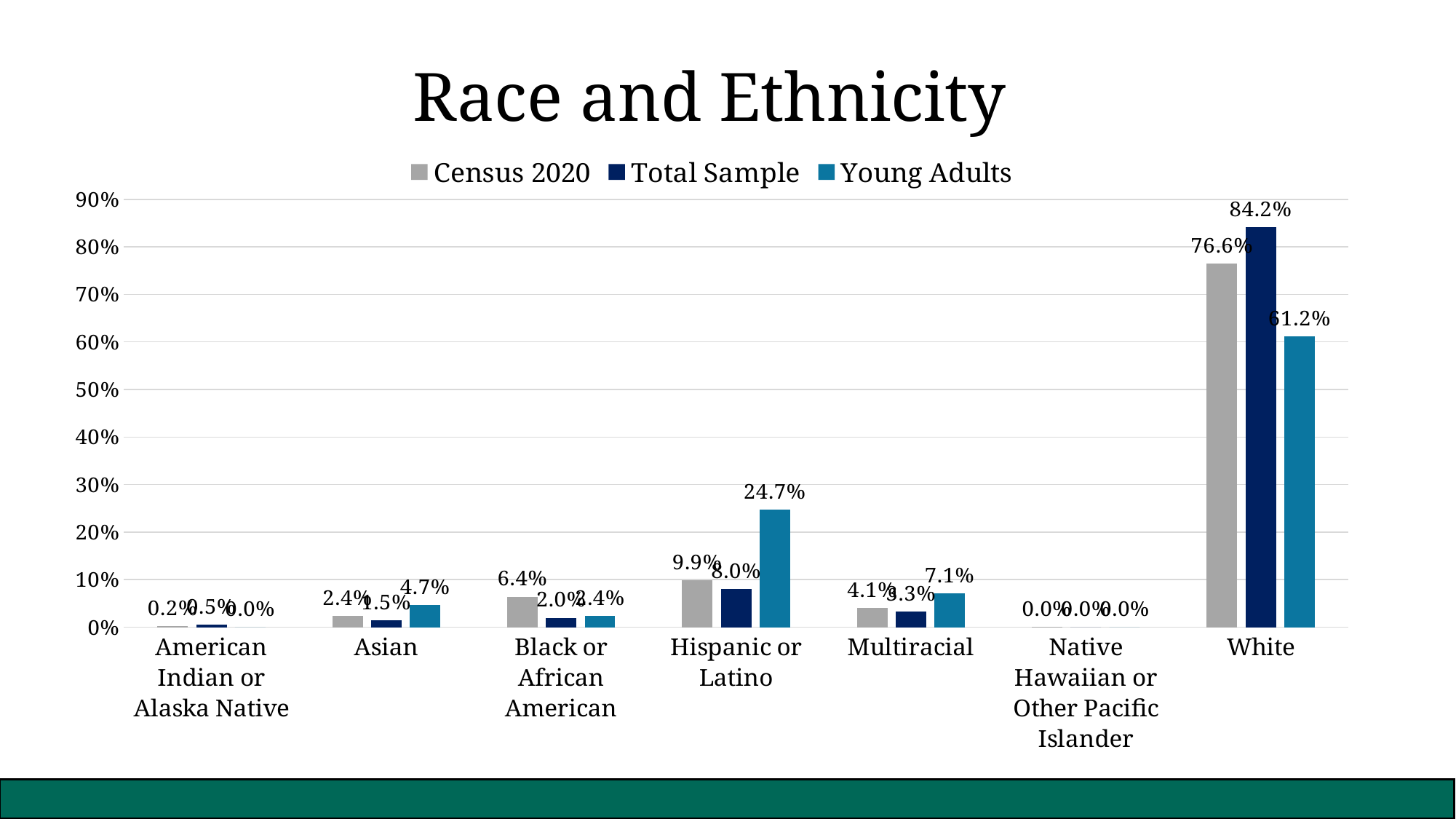
Is the Young Adults value for White greater or less than 70%? less What is the Total Sample value for White? 84.2% What is the Census 2020 value for Black or African American? 6.4% What is the Census 2020 value for White? 76.6% What is the Young Adults value for Hispanic or Latino? 24.7% How many series does the legend list? 3 What is the Young Adults value for Multiracial? 7.1% What kind of chart is shown on the slide? bar chart What is the difference between the Total Sample and Young Adults values for White? 23.0% How many race/ethnicity categories are shown on the x axis? 7 Which category has the highest Total Sample value? White Which is larger for Hispanic or Latino: the Census 2020 value or the Young Adults value? Young Adults